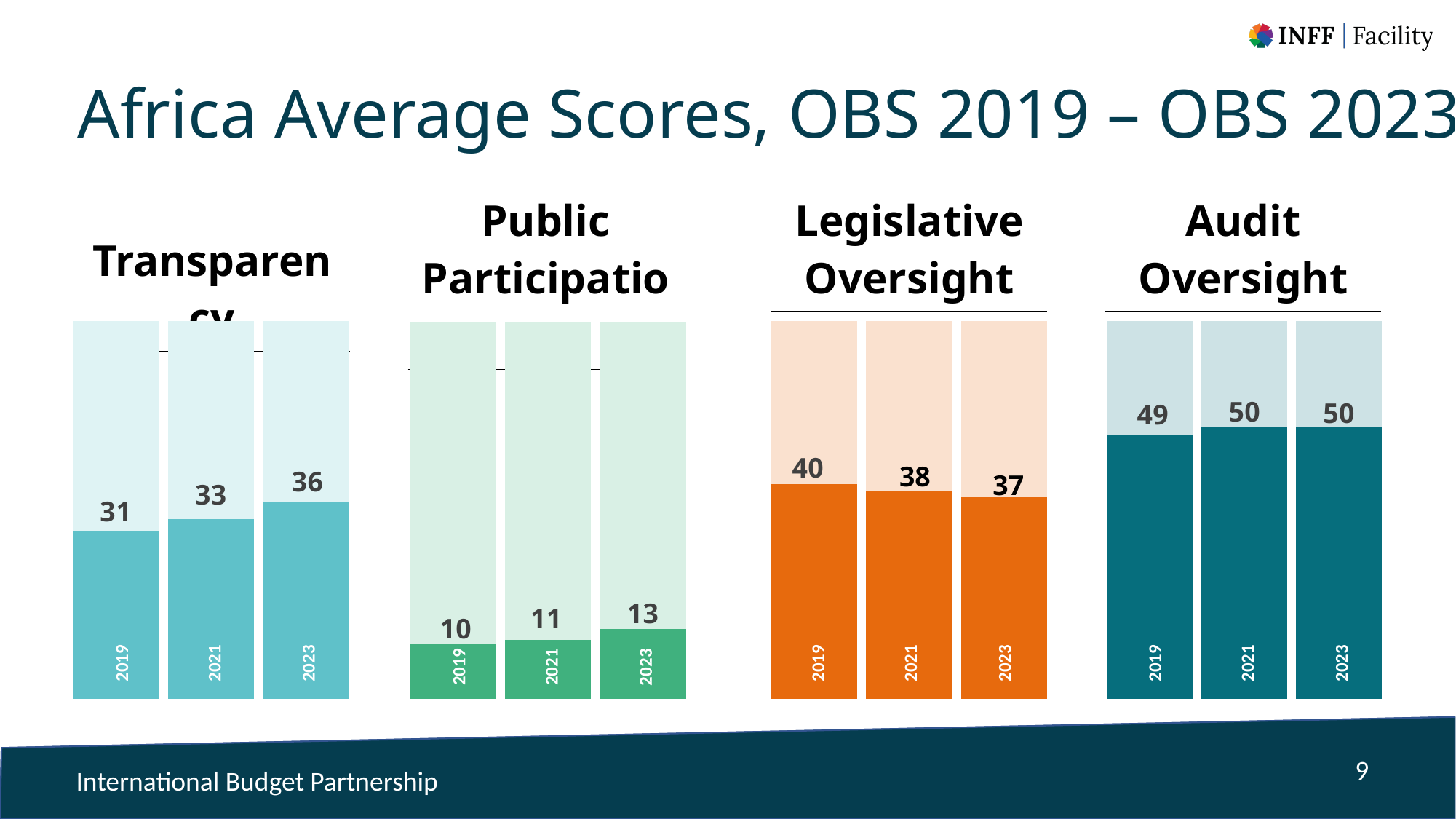
What type of chart is used for the Legislative Oversight scores? bar chart In the Transparency chart, what is the score for 2023? 36 In the Legislative Oversight chart, what is the score for 2021? 38 How many bars are shown in the Audit Oversight chart? 3 In the Public Participation chart, what is the difference between the 2023 score and the 2021 score? 2 In the Public Participation chart, what is the score for 2019? 10 In the Transparency chart, what is the difference between the 2023 score and the 2019 score? 5 In the Audit Oversight chart, what is the score for 2019? 49 Do the scores in the Public Participation chart rise or fall from 2019 to 2023? rise In the Legislative Oversight chart, which is larger, the 2019 score or the 2023 score? 2019 In the Transparency chart, which year has the lowest score? 2019 In the Legislative Oversight chart, which year has the highest score? 2019